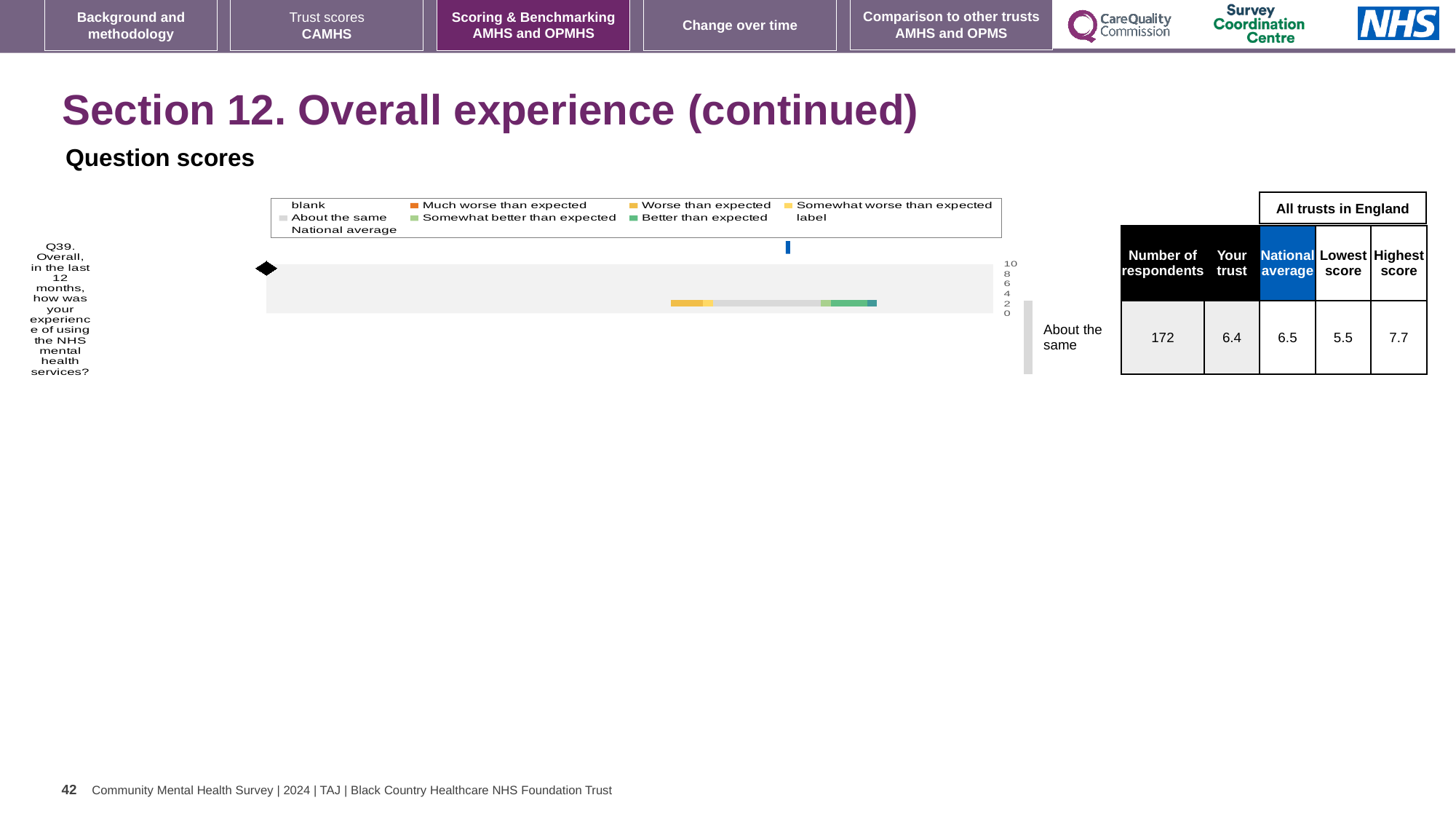
How many respondents answered Q39, according to the table? 172 How many survey questions are plotted in the chart on this slide? 1 What is the lowest score among all trusts in England for Q39, as shown in the table? 5.5 Is the 'Your trust' score for Q39 greater or less than 6? greater What is the difference between the highest score (7.7) and the lowest score (5.5) for Q39? 2.2 According to the table next to the chart, what is the 'Your trust' score for Q39? 6.4 What is the highest tick value shown on the chart's score axis? 10 According to the table next to the chart, what is the national average score for Q39? 6.5 What is the highest score among all trusts in England for Q39, as shown in the table? 7.7 What kind of chart is shown for Q39 on this slide? bar chart Which benchmarking category is the trust's Q39 score placed in, as labelled beside the chart? About the same For Q39, which is larger: the 'Your trust' score or the national average? National average